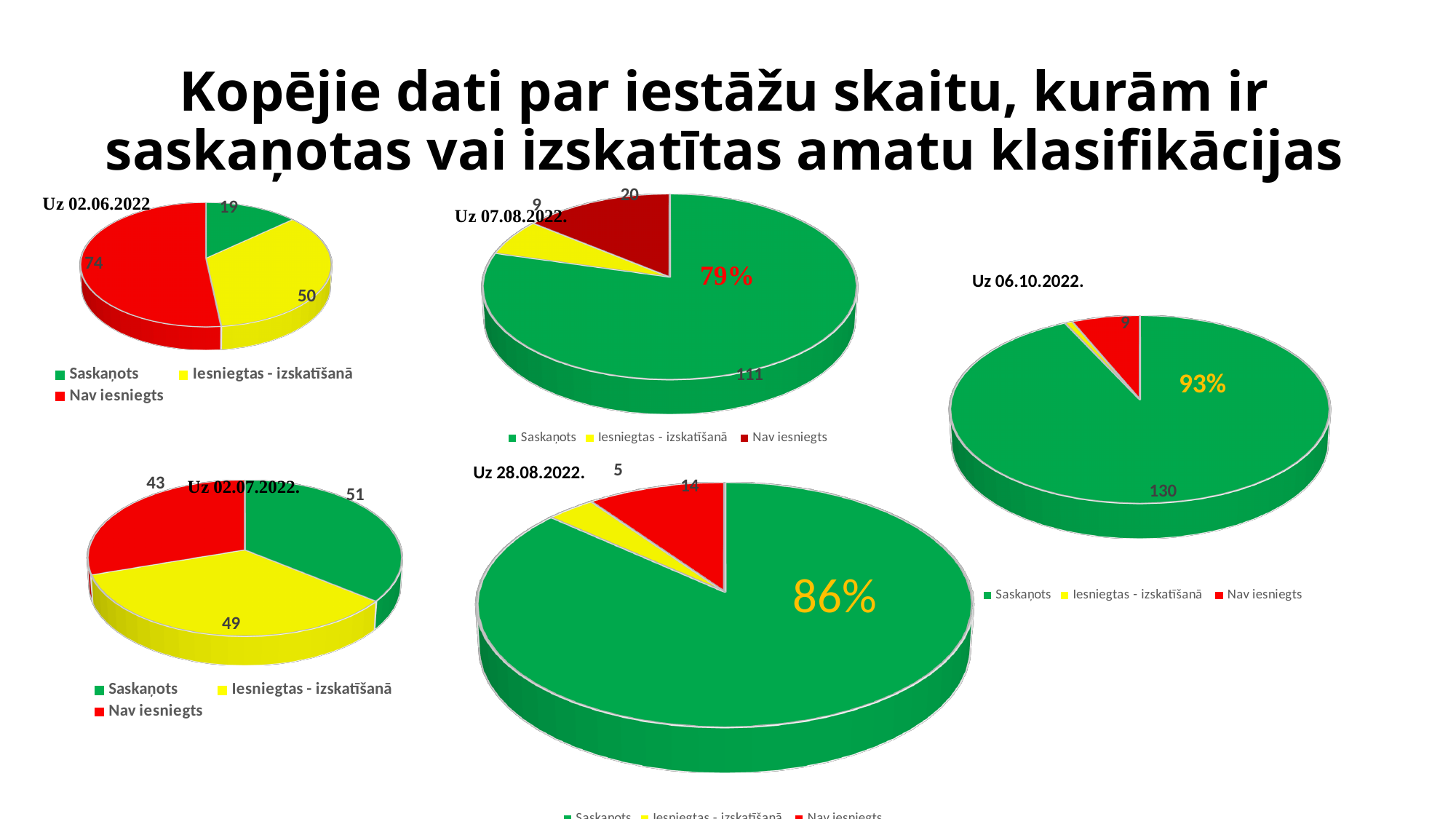
In the 'Uz 02.07.2022' pie chart, what is the value for Saskaņots? 51 In the 'Uz 02.06.2022' pie chart, which category has the smallest value? Saskaņots In the 'Uz 28.08.2022' pie chart, what is the value for Nav iesniegts? 14 In the 'Uz 02.07.2022' pie chart, what is the difference between Saskaņots and Nav iesniegts? 8 In the 'Uz 06.10.2022' pie chart, what is the value for Saskaņots? 130 In the 'Uz 02.06.2022' pie chart, what is the value for Nav iesniegts? 74 In the 'Uz 06.10.2022' pie chart, what percentage is printed on the Saskaņots slice? 93% In the 'Uz 07.08.2022' pie chart, what is the value for Saskaņots? 111 How many pie charts are shown on the slide? 5 In the 'Uz 07.08.2022' pie chart, what percentage is printed on the Saskaņots slice? 79% In the 'Uz 28.08.2022' pie chart, which is larger: Iesniegtas - izskatīšanā or Nav iesniegts? Nav iesniegts In the 'Uz 07.08.2022' pie chart, which category has the largest value? Saskaņots